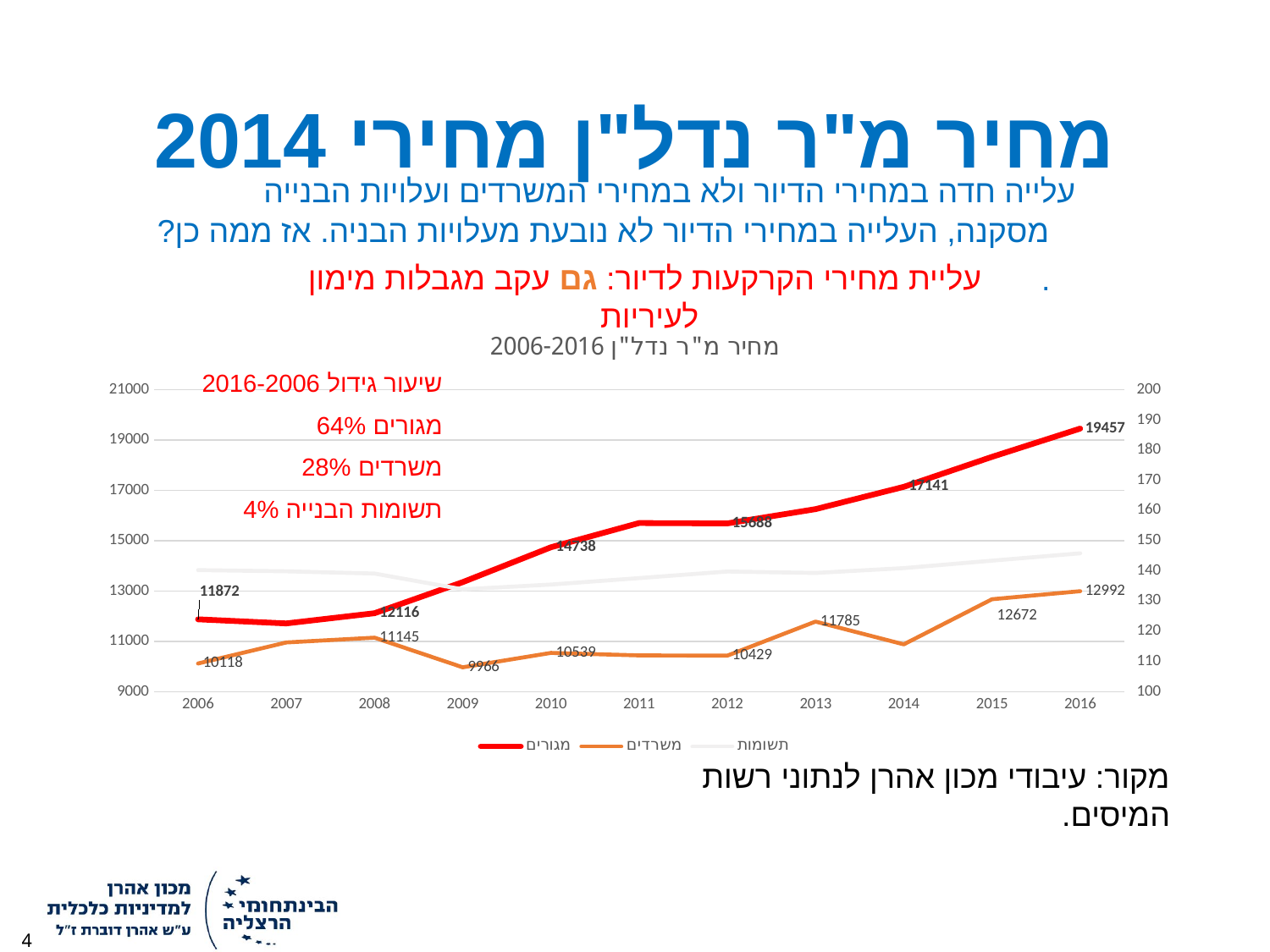
What is the difference between the מגורים and משרדים values in 2016? 6465 Is the מגורים value in 2012 greater or less than 15000? greater What is the value of the מגורים series in 2016? 19457 Which series has the higher value in 2014, מגורים or משרדים? מגורים What is the value of the משרדים series in 2016? 12992 Does the מגורים series rise or fall between 2008 and 2016? rise How many years are shown on the x axis of the chart? 11 What is the difference between the מגורים value in 2016 and in 2006? 7585 What kind of chart is shown on the slide? line chart What is the value of the משרדים series in 2009? 9966 How many series does the chart legend list? 3 What is the value of the מגורים series in 2006? 11872